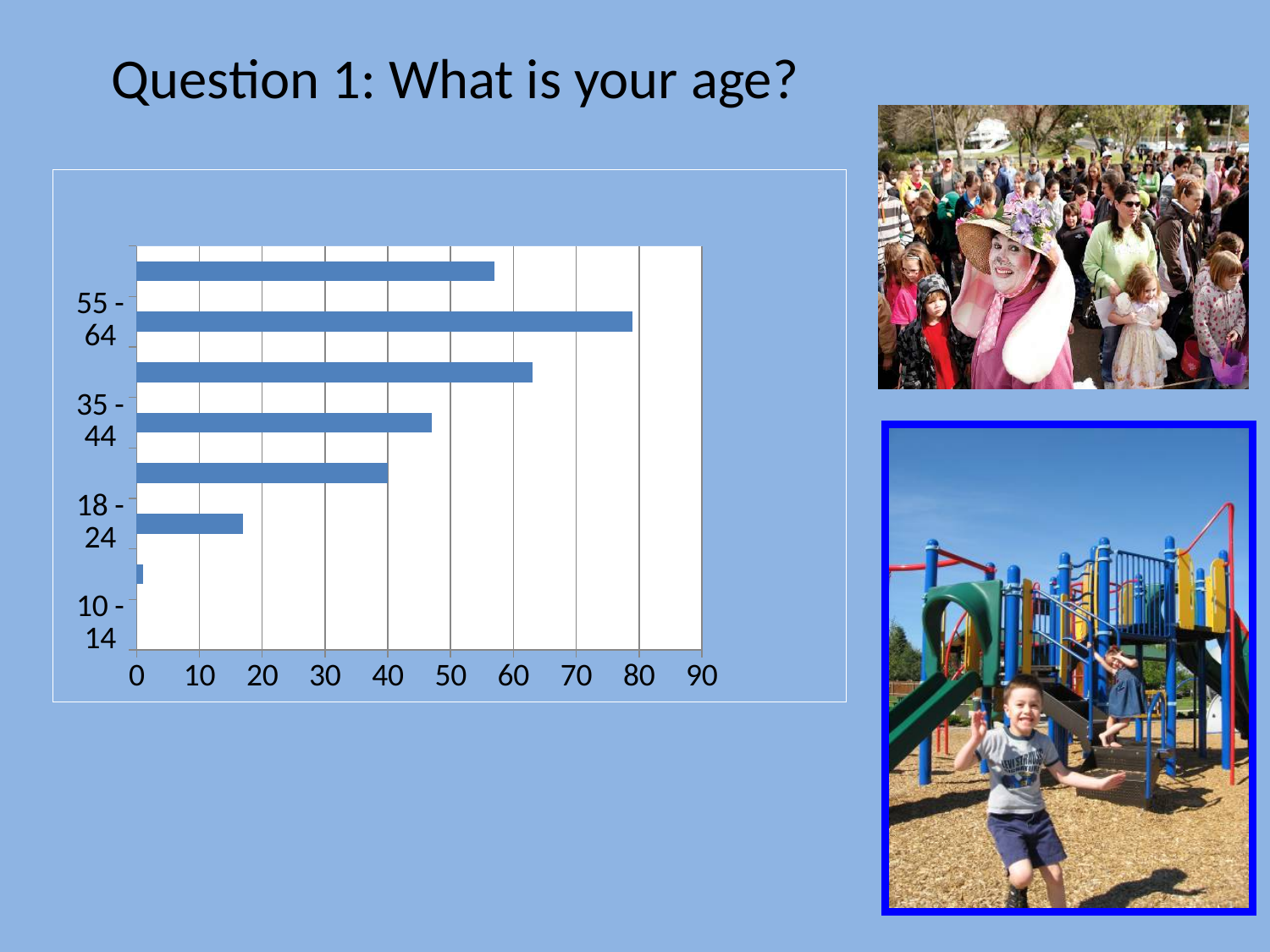
What question does the slide title say the chart is about? Question 1: What is your age? Is the value for the 35 - 44 age group greater or less than 60? less Is the value for the 35 - 44 age group greater or less than 40? greater Which has the larger value, the 35 - 44 age group or the 18 - 24 age group? 35 - 44 What kind of chart is shown on the slide? bar chart What is the highest value shown on the horizontal axis of the chart? 90 Is the value for the 18 - 24 age group greater or less than 30? less Which has the larger value, the 55 - 64 age group or the 35 - 44 age group? 55 - 64 Which labeled age group has the longest bar in the chart? 55 - 64